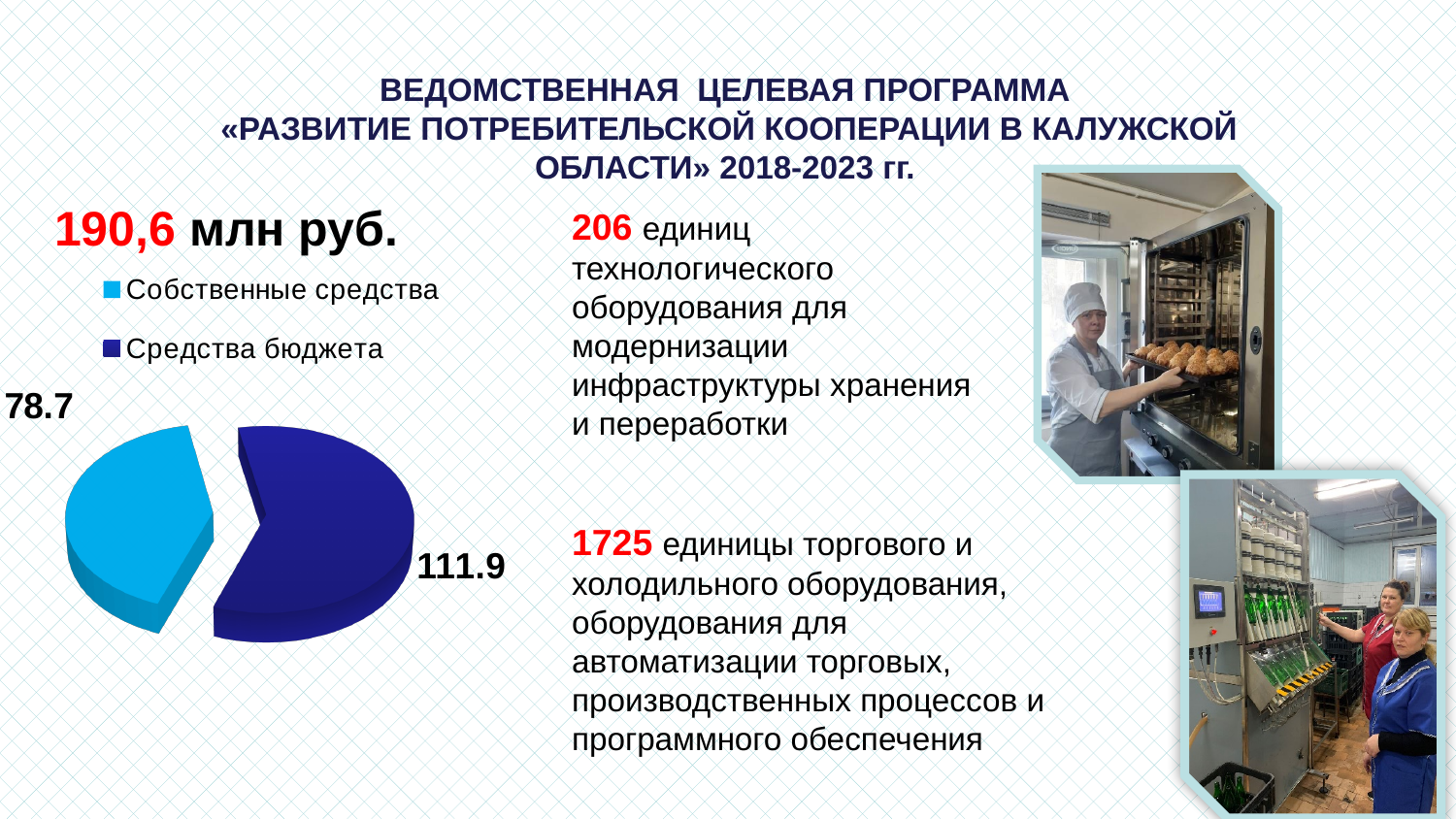
What kind of chart is shown on the slide? pie chart Which slice of the pie chart is the smallest? Собственные средства How many slices does the pie chart have? 2 What is the total of the two slices in the pie chart? 190.6 Which slice of the pie chart is the largest? Средства бюджета What is the value for Средства бюджета in the pie chart? 111.9 What is the difference between Средства бюджета and Собственные средства in the pie chart? 33.2 What is the value for Собственные средства in the pie chart? 78.7 How many entries does the legend of the pie chart list? 2 Which is larger in the pie chart: Собственные средства or Средства бюджета? Средства бюджета What share of the pie chart does Средства бюджета represent? 58.7% Which colour represents Собственные средства in the pie chart? light blue